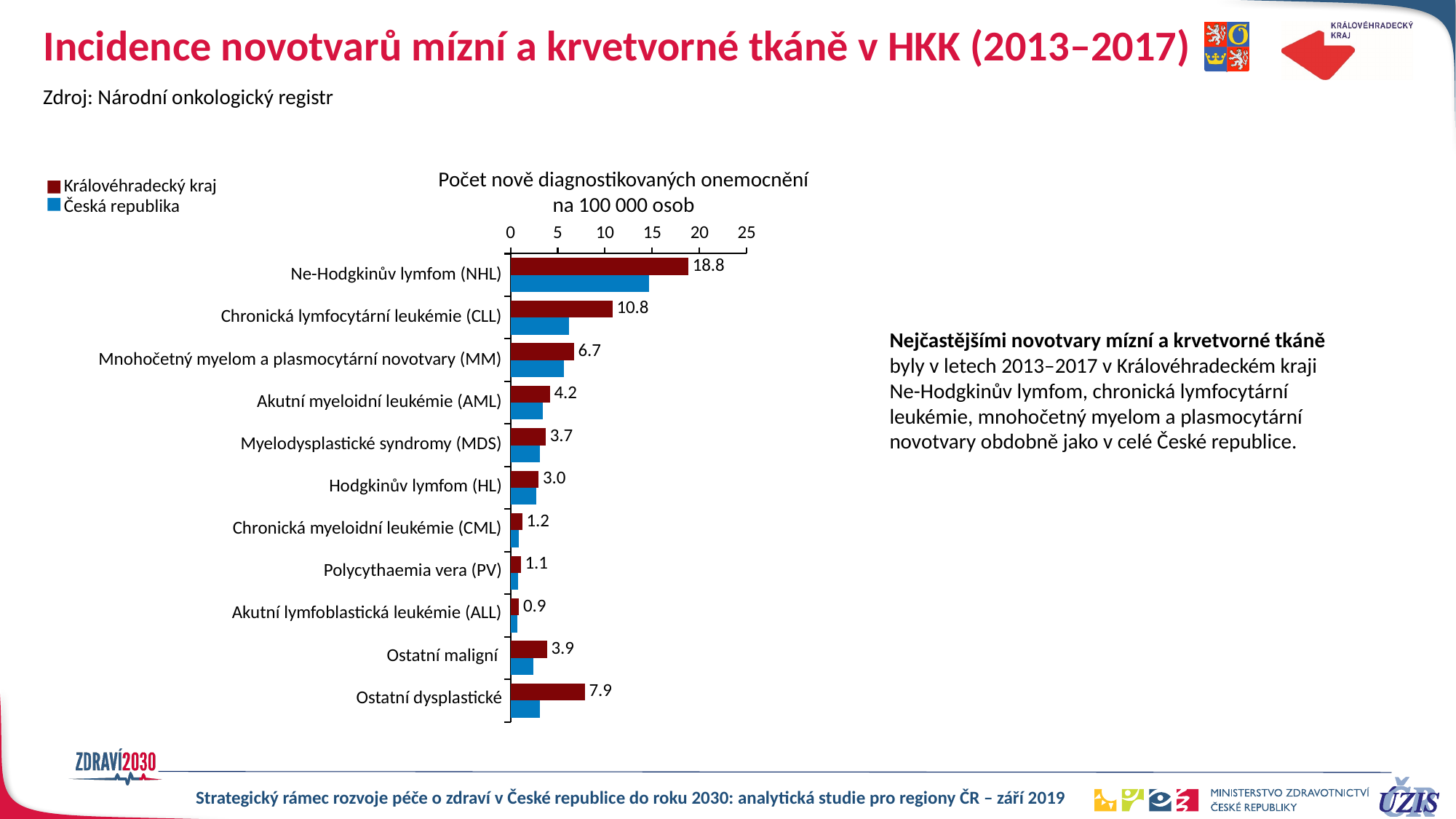
What is the value for Královéhradecký kraj for Ne-Hodgkinův lymfom (NHL)? 18.8 What is the difference between the Královéhradecký kraj values for Ne-Hodgkinův lymfom (NHL) and Chronická lymfocytární leukémie (CLL)? 8.0 How many series does the legend list? 2 Which category has the highest value for Královéhradecký kraj? Ne-Hodgkinův lymfom (NHL) For Královéhradecký kraj, which is larger: Mnohočetný myelom a plasmocytární novotvary (MM) or Ostatní dysplastické? Ostatní dysplastické What is the value for Královéhradecký kraj for Chronická lymfocytární leukémie (CLL)? 10.8 Which category has the lowest value for Královéhradecký kraj? Akutní lymfoblastická leukémie (ALL) Is the value for Česká republika for Ne-Hodgkinův lymfom (NHL) greater or less than 10? greater Is the value for Česká republika for Chronická lymfocytární leukémie (CLL) greater or less than 10? less What kind of chart is shown on the slide? bar chart What is the value for Královéhradecký kraj for Ostatní dysplastické? 7.9 How many categories (diagnoses) are shown on the chart? 11